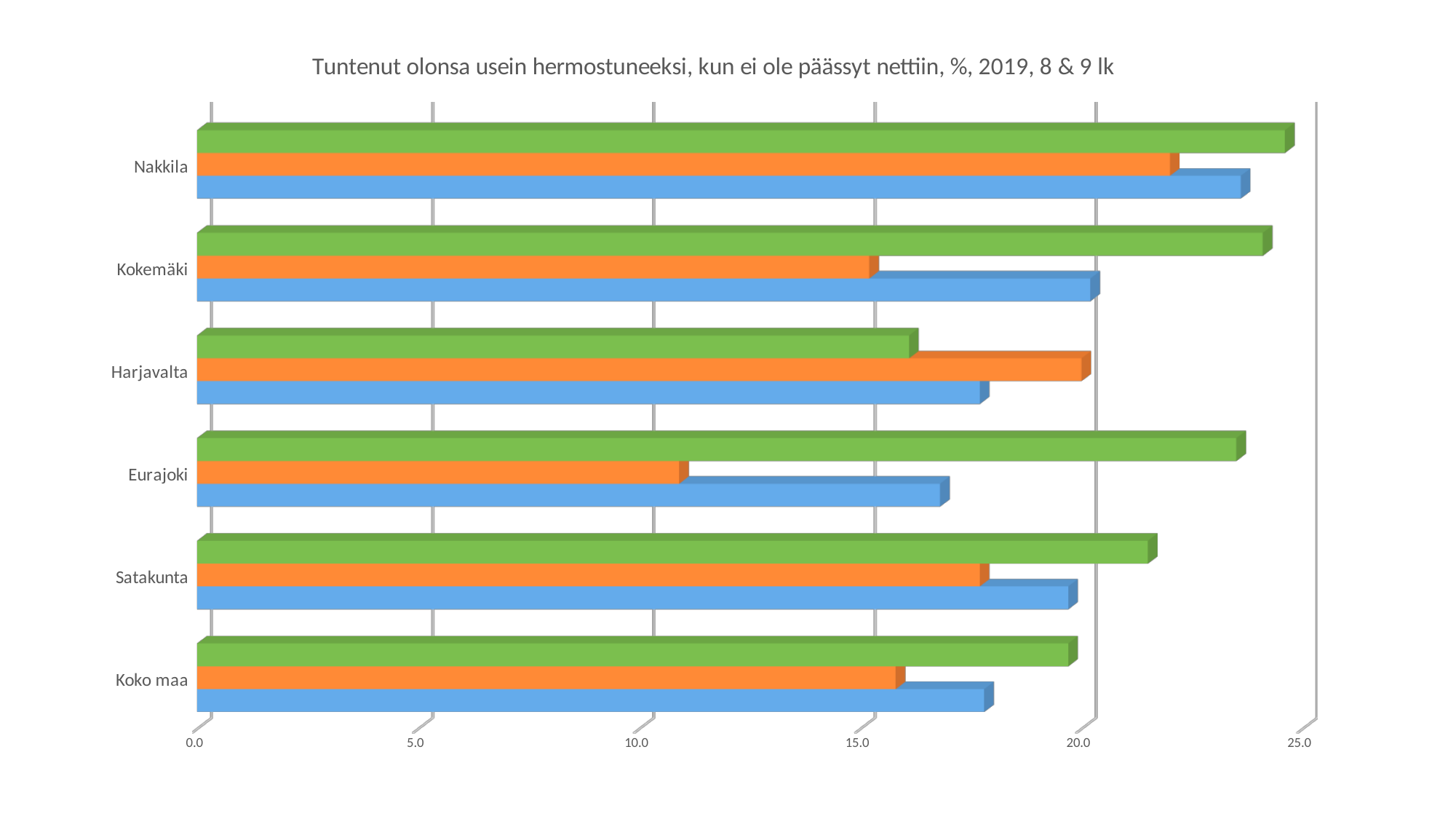
Is the value of the orange bar for Eurajoki greater or less than 15.0? less Is the value of the green bar for Nakkila greater or less than 20.0? greater How many categories are shown on the vertical axis of the chart? 6 Which category has the longest blue bar? Nakkila What is the title of the chart? Tuntenut olonsa usein hermostuneeksi, kun ei ole päässyt nettiin, %, 2019, 8 & 9 lk How many bars are plotted for each category in the chart? 3 Which category has the shortest orange bar? Eurajoki Is the value of the green bar for Satakunta greater or less than 20.0? greater What kind of chart is shown on the slide? bar chart Which category has the shortest green bar? Harjavalta For Harjavalta, which bar is longer, the orange bar or the green bar? orange